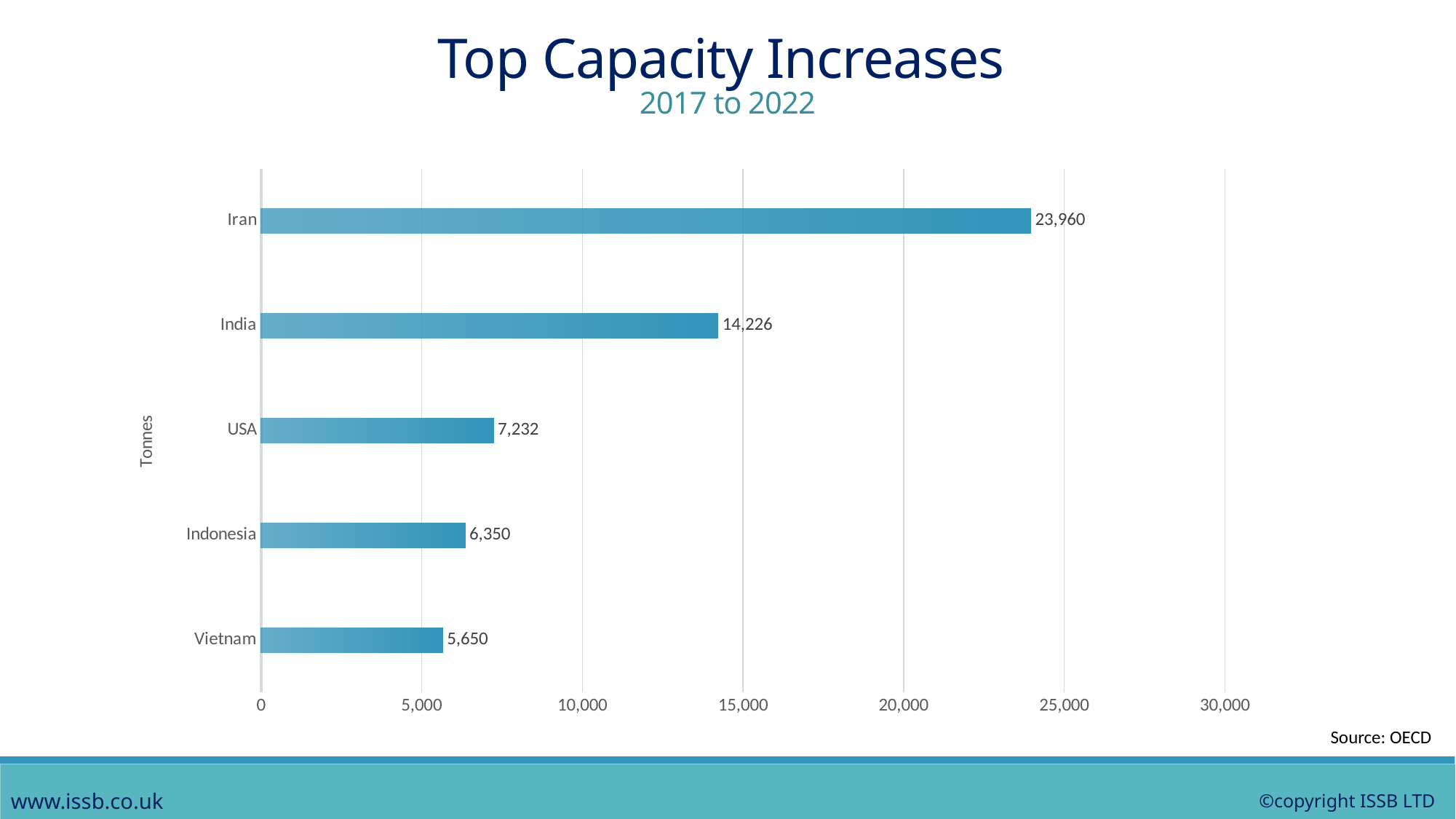
What is the title of the chart? Top Capacity Increases What is the difference between the values for USA and Vietnam? 1,582 What is the difference between the values for Iran and India? 9,734 Is the value for India greater or less than 15,000? less Which has a larger capacity increase, USA or Indonesia? USA How many countries are shown in the chart? 5 What is the capacity increase value for India? 14,226 Which country has the highest capacity increase? Iran Which country has the lowest capacity increase? Vietnam What is the capacity increase value for Indonesia? 6,350 What kind of chart is shown on the slide? Bar chart What is the capacity increase value for Iran? 23,960